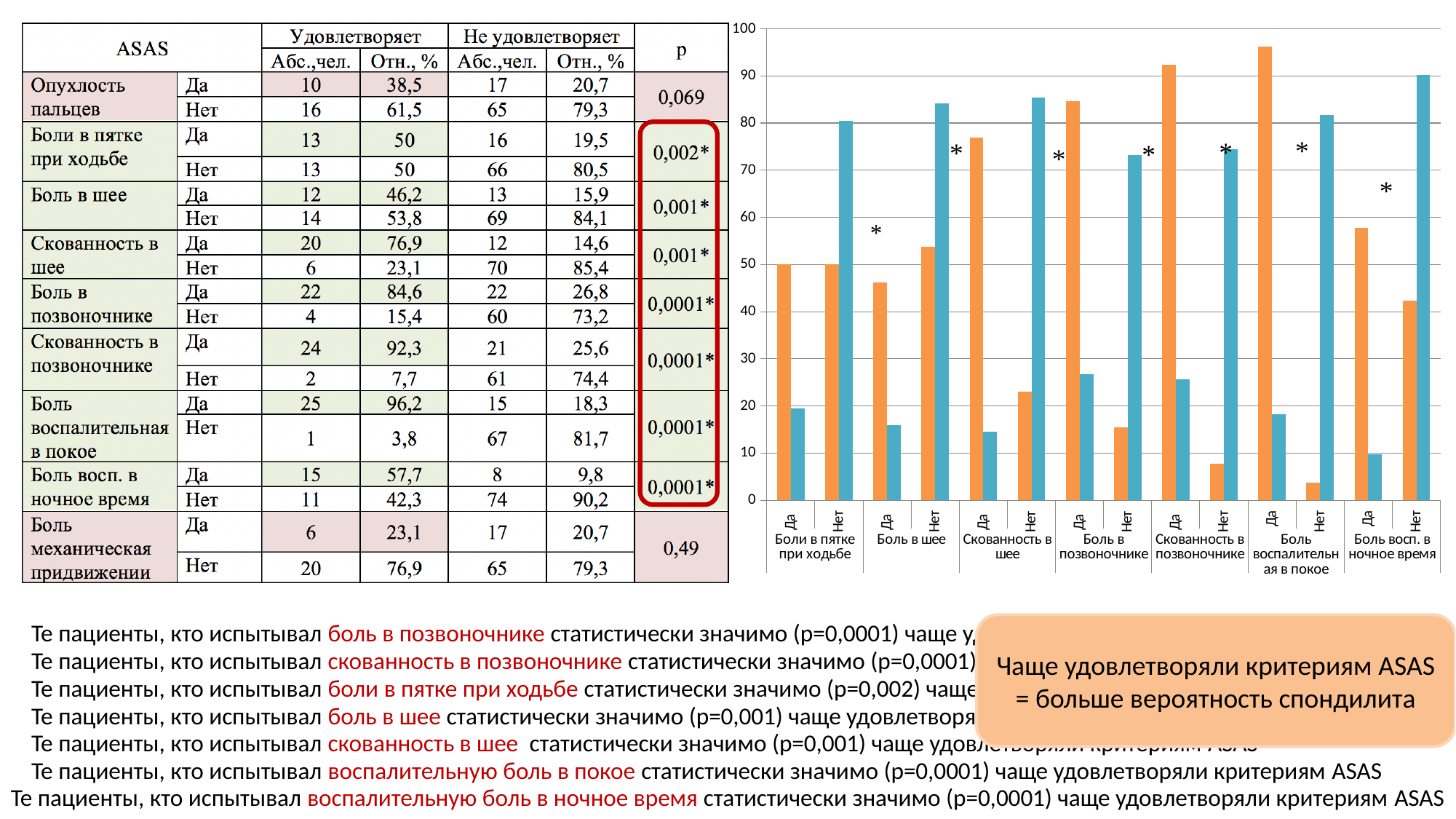
What kind of chart is shown on the right side of the slide? bar chart In the bar chart, which category has the shortest orange bar? Боль воспалительная в покое, Нет In the bar chart, is the orange bar for 'Нет' under 'Скованность в позвоночнике' greater or less than 10? less How many differently coloured bar series does the bar chart show? 2 In the bar chart, is the blue bar for 'Нет' under 'Скованность в шее' greater or less than 80? greater In the bar chart, is the blue bar for 'Да' under 'Боль воспалительная в покое' greater or less than 20? less How many symptom groups are shown along the x axis of the bar chart? 7 In the bar chart, what is the value of the orange bar for 'Да' under 'Боли в пятке при ходьбе'? 50 What is the highest value shown on the y axis of the bar chart? 100 In the bar chart, for 'Да' under 'Боль в шее', which bar is taller, the orange or the blue one? orange In the bar chart, which category has the tallest orange bar? Боль воспалительная в покое, Да